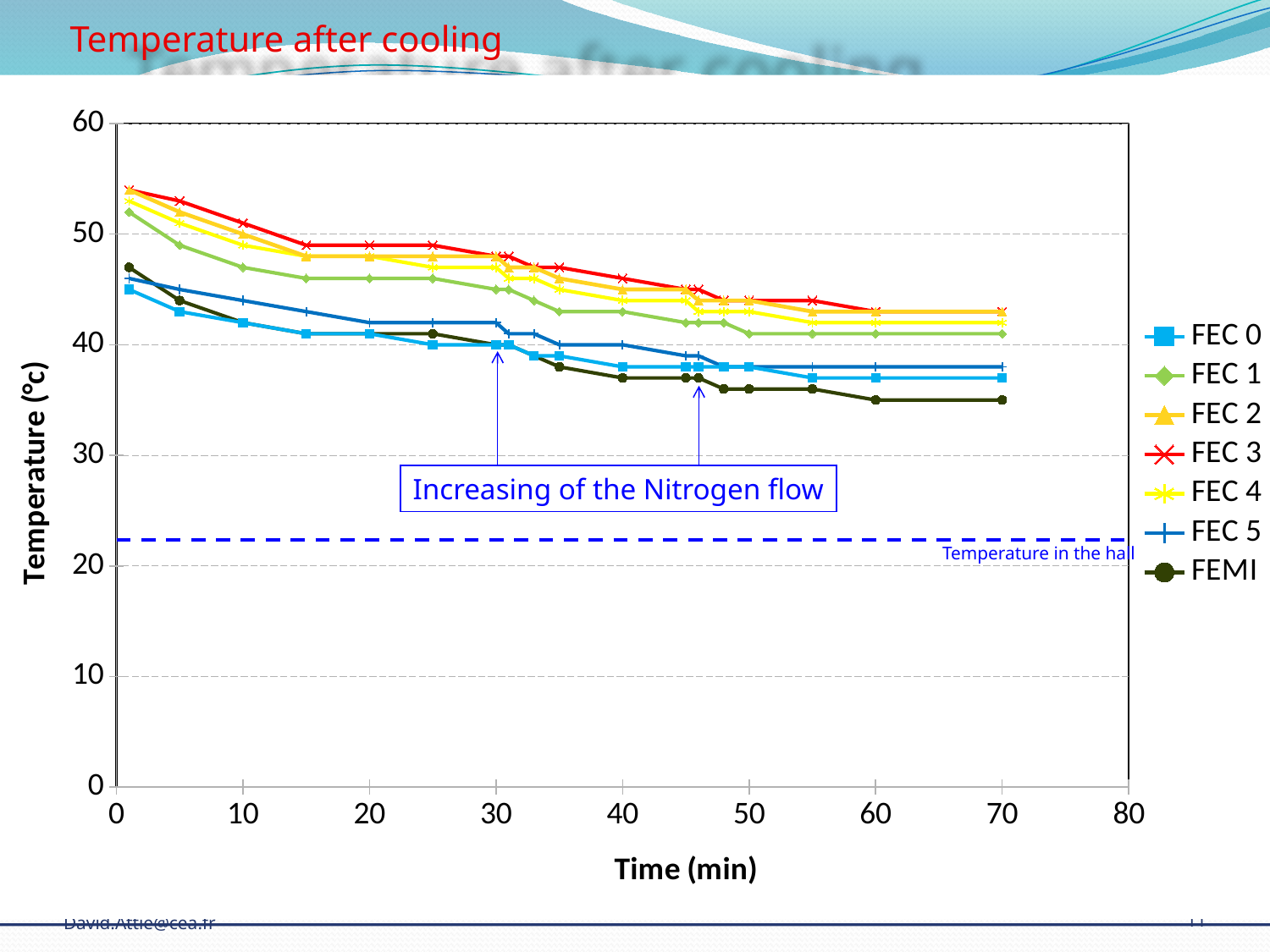
Is the temperature of FEC 3 at 1 min greater or less than 50? greater What does the boxed annotation inside the chart say? Increasing of the Nitrogen flow Do the temperatures rise or fall as time increases along the x axis? fall At 1 min, which is higher: FEC 0 or FEC 3? FEC 3 Which series has the highest temperature at the start of the measurement (around 1 min)? FEC 2 and FEC 3 (tied) How many series does the legend list? 7 At 70 min, which is higher: FEC 3 or FEMI? FEC 3 Which series has the lowest temperature at 70 min? FEMI Is the temperature of FEMI at 70 min greater or less than 40? less Is the temperature of FEC 5 at 1 min greater or less than 50? less What is the title of the chart? Temperature after cooling What kind of chart is shown on the slide? line chart